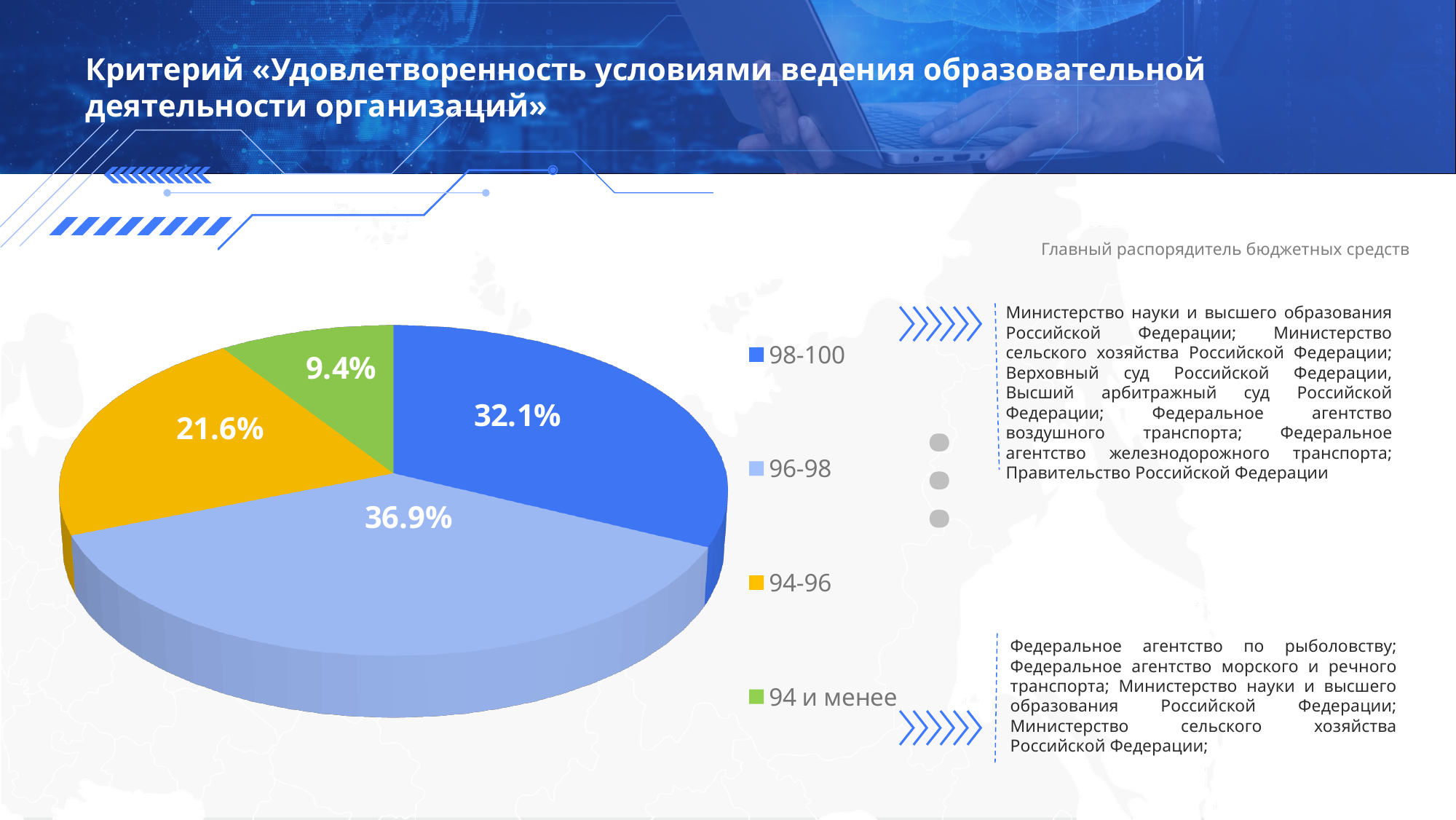
What is the difference in percentage points between the "96-98" slice and the "98-100" slice? 4.8 How many slices does the pie chart have? 4 Which slice is larger: "94-96" or "94 и менее"? 94-96 What type of chart is shown on the slide? Pie chart What share of the pie does the "94-96" slice represent? 21.6% What share of the pie does the "98-100" slice represent? 32.1% Which category has the smallest slice of the pie? 94 и менее What share of the pie does the "94 и менее" slice represent? 9.4% What colour is the "94-96" slice in the pie chart? Yellow What share of the pie does the "96-98" slice represent? 36.9% What is the difference in percentage points between the "94-96" slice and the "94 и менее" slice? 12.2 Which category has the largest slice of the pie? 96-98